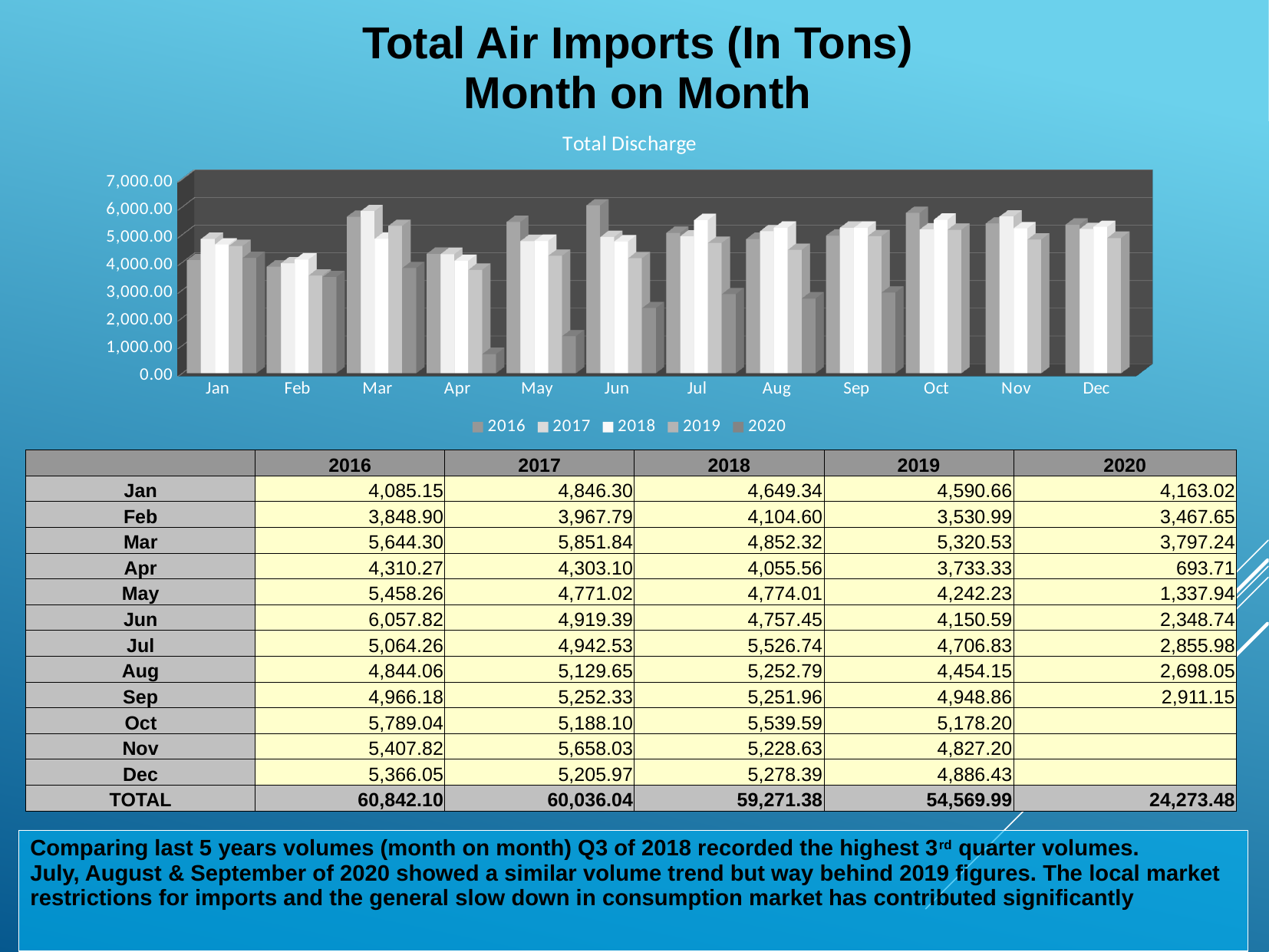
Which month has the lowest value in the 2020 series? Apr What is the difference between the Mar values for 2017 and 2020? 2,054.60 What kind of chart is shown on the slide? bar chart How many series does the chart legend list? 5 Is the value for Apr in the 2020 series greater or less than 1,000.00? less Which month has the highest value in the 2016 series? Jun How many months are shown along the x axis of the chart? 12 What is the value for Jan in the 2016 series? 4,085.15 What is the value for Apr in the 2020 series? 693.71 What is the title printed above the chart? Total Discharge Do the 2020 values rise or fall from Apr to Jul? rise For Jul, which series has the larger value, 2018 or 2019? 2018